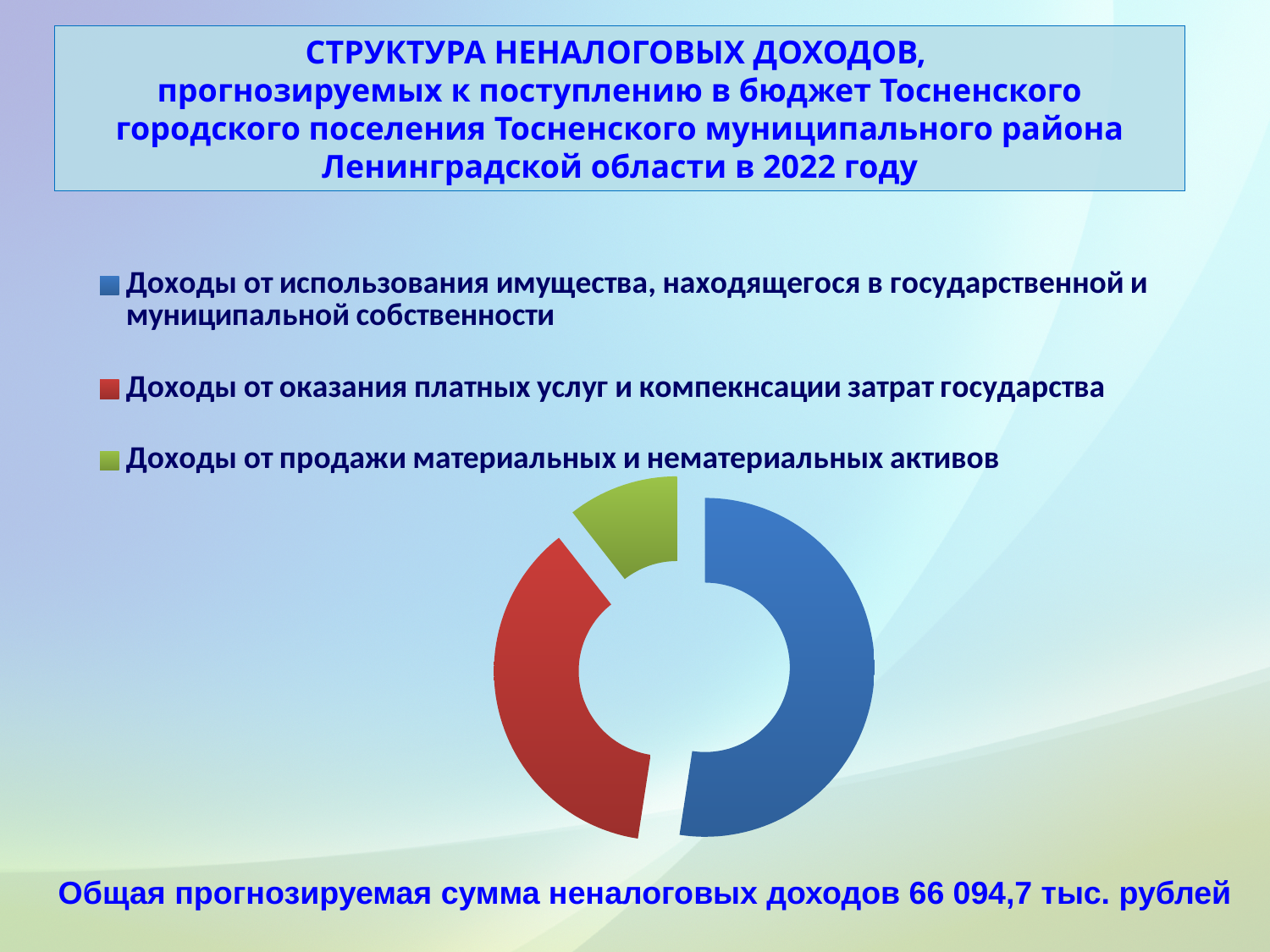
How many categories (segments) does the chart show? 3 Which category has the largest share of the chart? Доходы от использования имущества, находящегося в государственной и муниципальной собственности How many entries does the chart's legend list? 3 Which category is shown in red in the chart? Доходы от оказания платных услуг и компекнсации затрат государства Which category has the smallest share of the chart? Доходы от продажи материальных и нематериальных активов What colour represents 'Доходы от продажи материальных и нематериальных активов' in the chart? Green Which is larger: the share for 'Доходы от использования имущества, находящегося в государственной и муниципальной собственности' or the share for 'Доходы от оказания платных услуг и компекнсации затрат государства'? Доходы от использования имущества, находящегося в государственной и муниципальной собственности Which is larger: the share for 'Доходы от оказания платных услуг и компекнсации затрат государства' or the share for 'Доходы от продажи материальных и нематериальных активов'? Доходы от оказания платных услуг и компекнсации затрат государства What kind of chart is shown on the slide? Doughnut (pie) chart